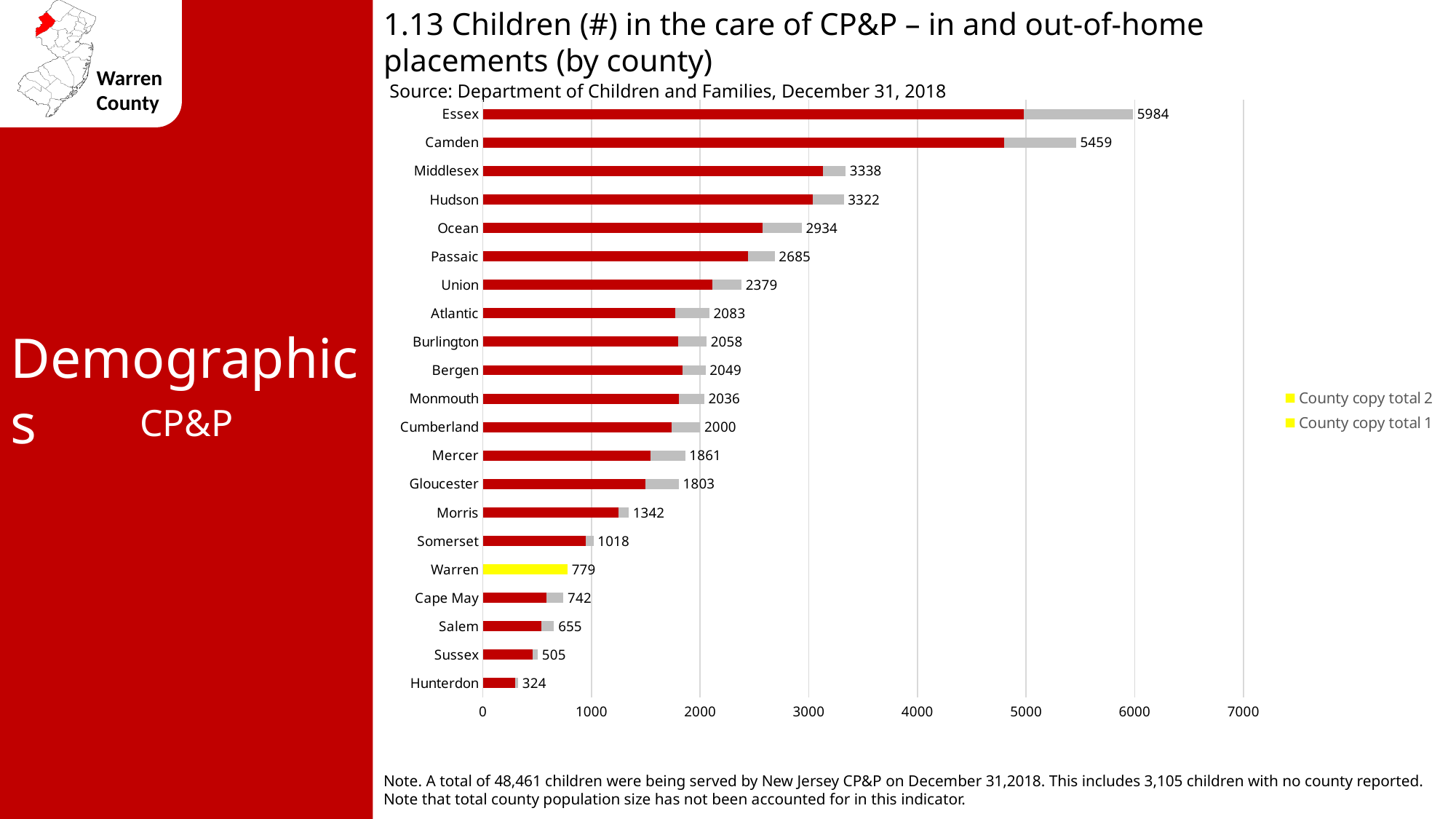
What kind of chart is shown on the slide? Bar chart What is the total value shown for Cumberland county? 2000 What is the difference between the totals for Essex and Camden? 525 Which county has the highest total number of children in the care of CP&P? Essex Which county has a larger total, Ocean or Passaic? Ocean What is the total value shown for Warren county? 779 How many counties are shown on the chart? 21 What is the total number of children in the care of CP&P for Essex county? 5984 What is the difference between the totals for Warren and Cape May? 37 Which county's bar is highlighted in yellow? Warren Which county has the lowest total number of children in the care of CP&P? Hunterdon How many series does the legend list? 2